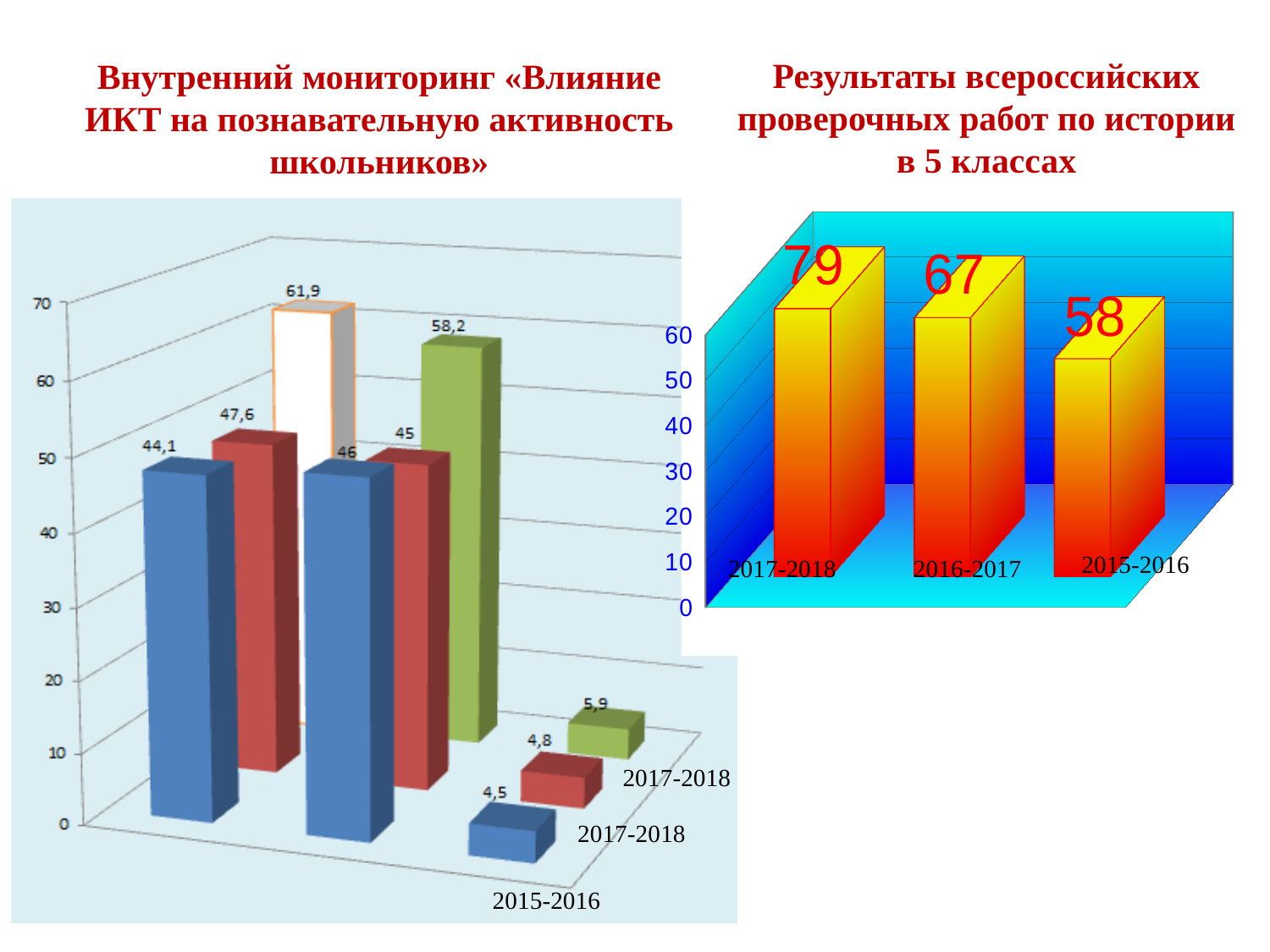
In the chart 'Результаты всероссийских проверочных работ по истории в 5 классах', which is larger: the value for 2016-2017 or the value for 2015-2016? 2016-2017 In the left chart 'Внутренний мониторинг', what is the lowest data label shown? 4,5 In the chart 'Результаты всероссийских проверочных работ по истории в 5 классах', what is the value for 2015-2016? 58 In the left chart 'Внутренний мониторинг', how many bars are plotted in total? 9 What kind of chart is the one on the left, 'Внутренний мониторинг «Влияние ИКТ на познавательную активность школьников»'? bar chart In the left chart 'Внутренний мониторинг', what is the highest data label shown? 61,9 In the chart 'Результаты всероссийских проверочных работ по истории в 5 классах', what is the value for 2017-2018? 79 In the chart 'Результаты всероссийских проверочных работ по истории в 5 классах', do the values rise or fall from left to right along the x axis? fall In the chart 'Результаты всероссийских проверочных работ по истории в 5 классах', which year has the lowest value? 2015-2016 In the chart 'Результаты всероссийских проверочных работ по истории в 5 классах', which year has the highest value? 2017-2018 In the chart 'Результаты всероссийских проверочных работ по истории в 5 классах', what is the difference between the values for 2017-2018 and 2015-2016? 21 In the chart 'Результаты всероссийских проверочных работ по истории в 5 классах', how many bars are shown? 3